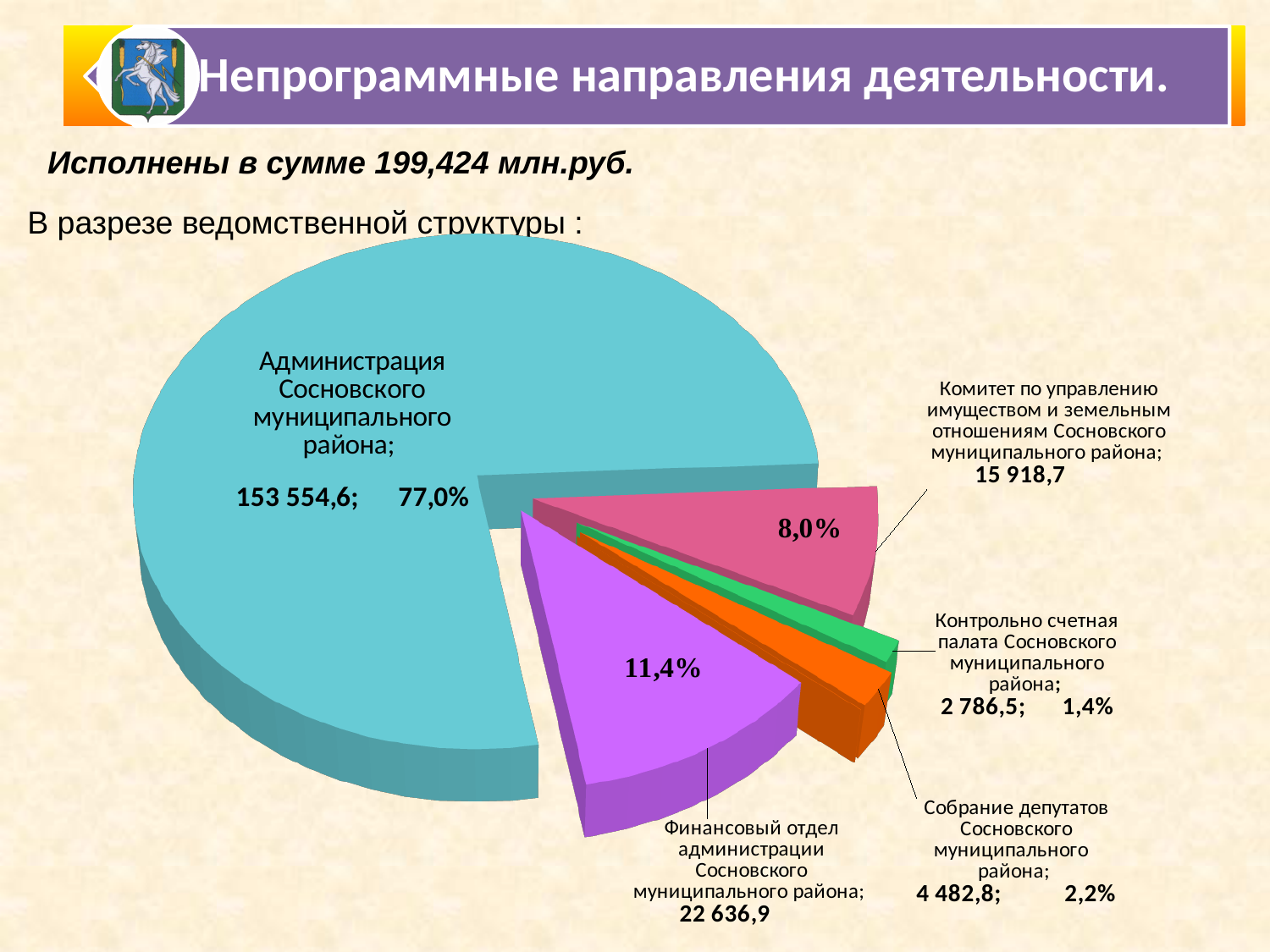
What is the value for Финансовый отдел администрации Сосновского муниципального района? 22 636,9 What share of the pie does Собрание депутатов Сосновского муниципального района have? 2,2% What share of the pie does Администрация Сосновского муниципального района have? 77,0% What is the difference between the shares of Финансовый отдел администрации Сосновского муниципального района and Комитет по управлению имуществом и земельным отношениям Сосновского муниципального района? 3,4% What share of the pie does Финансовый отдел администрации Сосновского муниципального района have? 11,4% What is the value for Комитет по управлению имуществом и земельным отношениям Сосновского муниципального района? 15 918,7 Which category has the largest slice of the pie? Администрация Сосновского муниципального района Which is larger: the value for Собрание депутатов Сосновского муниципального района or for Контрольно счетная палата Сосновского муниципального района? Собрание депутатов Сосновского муниципального района What kind of chart is shown on the slide? pie chart What is the value for Администрация Сосновского муниципального района? 153 554,6